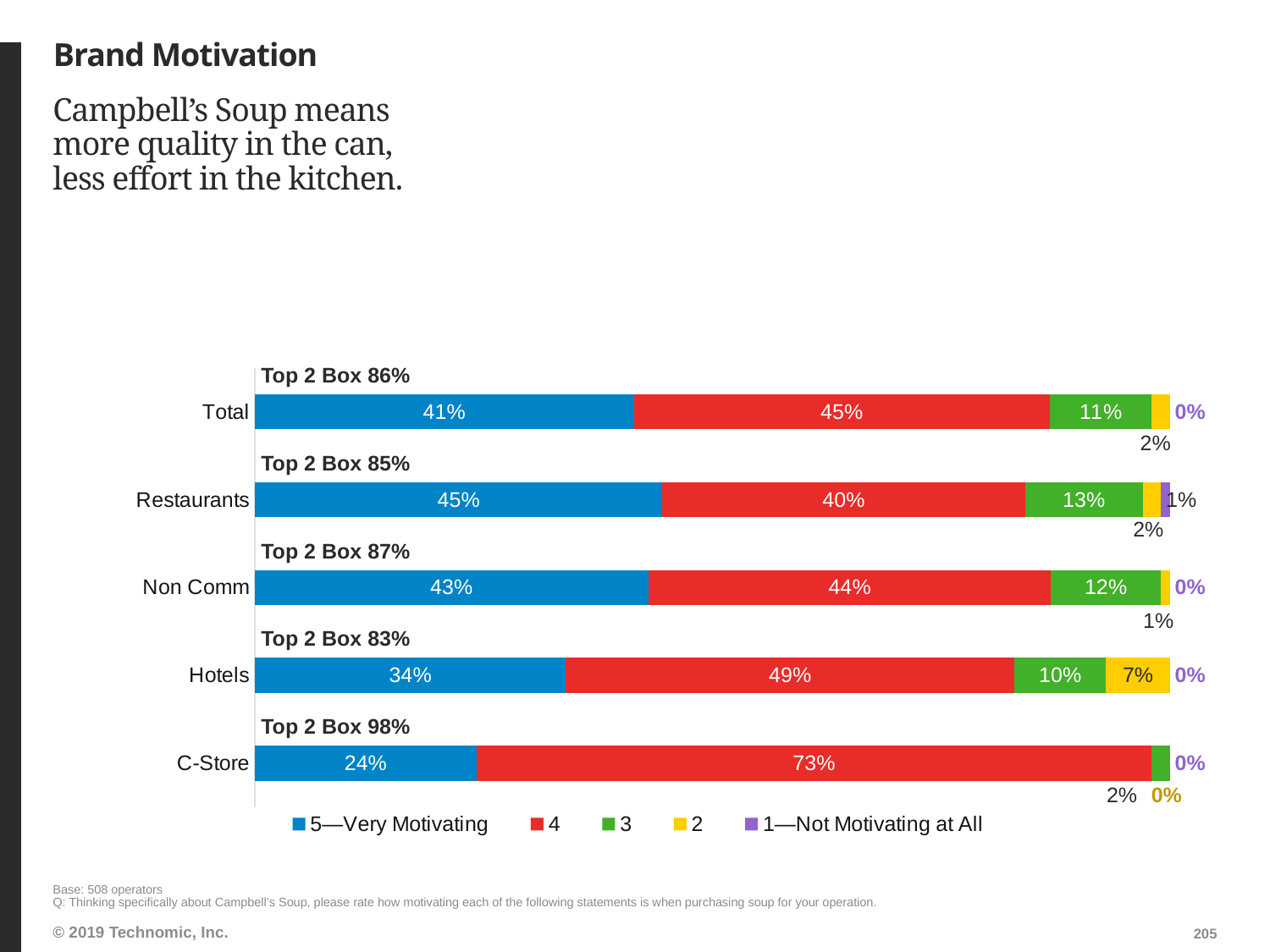
What percentage of Restaurants gave a rating of 3? 13% What is the difference between the 4 rating for C-Store and the 4 rating for Total? 28% Which category has the lowest Top 2 Box value? Hotels Which is larger: the 5—Very Motivating share for Non Comm or for Hotels? Non Comm What is the Top 2 Box value for Non Comm? 87% Which category has the highest share of 5—Very Motivating ratings? Restaurants How many categories are shown on the chart? 5 What type of chart is shown on the slide? Stacked bar chart What percentage of C-Store operators gave a rating of 4? 73% How many series does the legend list? 5 What percentage of Hotels rated the statement 5—Very Motivating? 34% What colour represents the 4 rating in the chart? Red